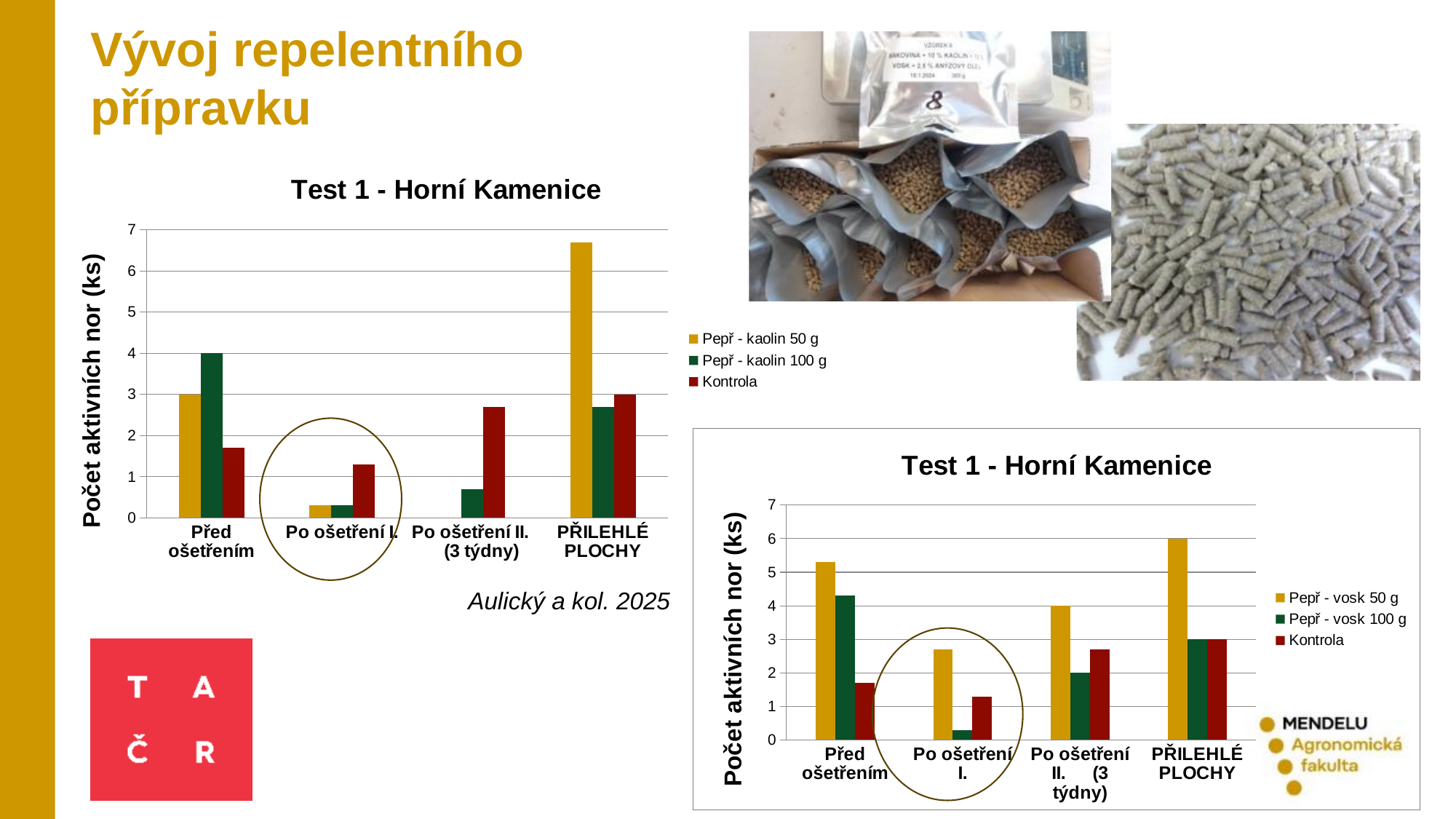
On the bottom-right chart, what is the value for Pepř - vosk 100 g at Po ošetření II. (3 týdny)? 2 On the bottom-right chart, which series has the lowest bar at Po ošetření I.? Pepř - vosk 100 g On the bottom-right chart, what is the label of the y axis? Počet aktivních nor (ks) On the bottom-right chart, what is the value for Pepř - vosk 50 g at PŘILEHLÉ PLOCHY? 6 On the left chart, in which category is the Pepř - kaolin 50 g bar highest? PŘILEHLÉ PLOCHY On the left chart, what kind of chart is shown? bar chart On the left chart, how many categories are shown on the x axis? 4 On the left chart, at Po ošetření II. (3 týdny), which is larger: Kontrola or Pepř - kaolin 100 g? Kontrola On the left chart, what is the value for Pepř - kaolin 100 g at Před ošetřením? 4 On the left chart, how many series does the legend list? 3 On the left chart, is the value for Pepř - kaolin 50 g at PŘILEHLÉ PLOCHY greater or less than 6? greater On the bottom-right chart, is the value for Pepř - vosk 50 g at Před ošetřením greater or less than 5? greater